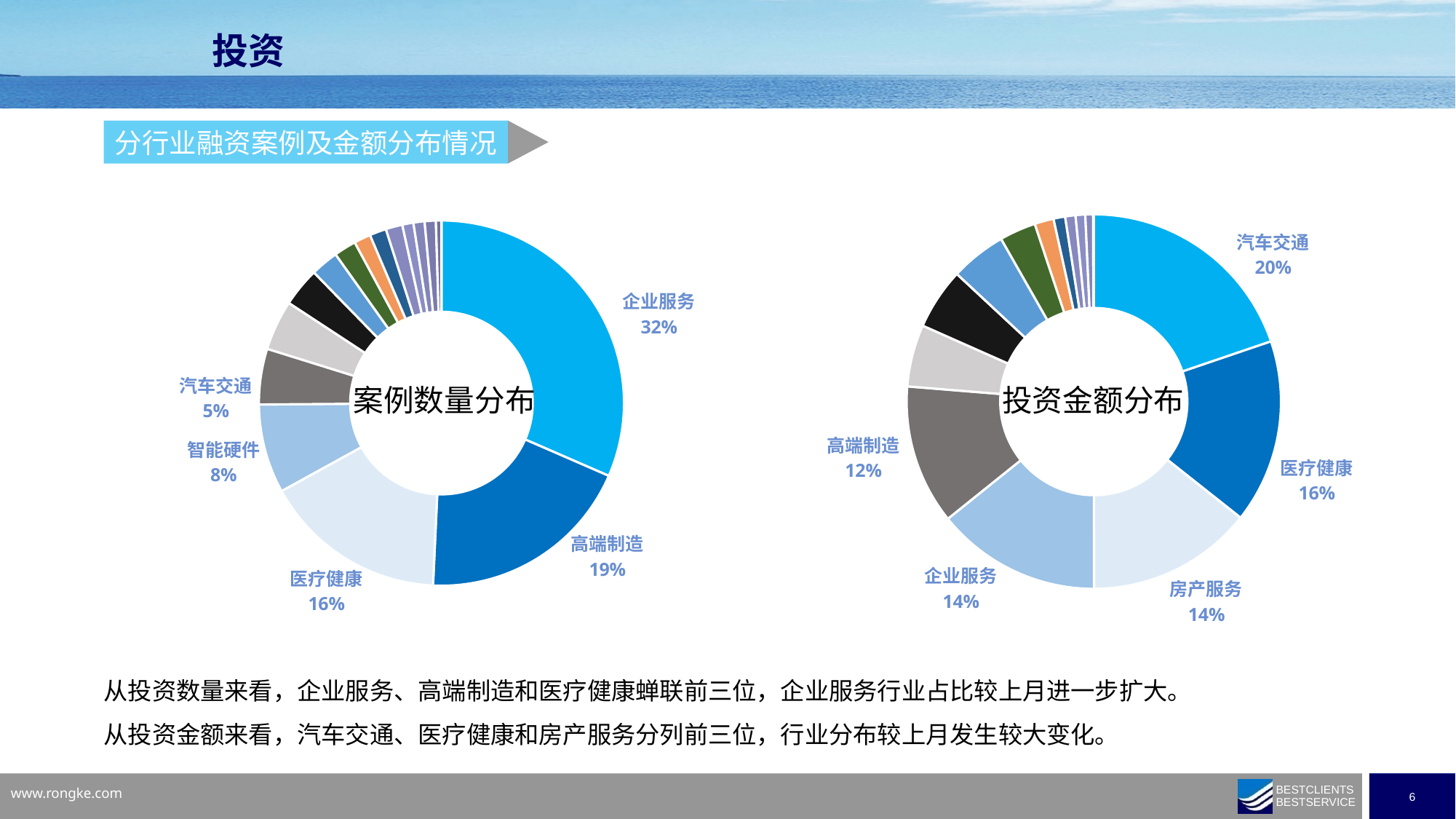
In the 投资金额分布 chart, which is larger, 医疗健康 or 房产服务? 医疗健康 In the 案例数量分布 chart, what share is labeled for 企业服务? 32% In the 案例数量分布 chart, what share is labeled for 汽车交通? 5% In the 案例数量分布 chart, how many percentage points larger is 企业服务 than 高端制造? 13 percentage points In the 案例数量分布 chart, what share is labeled for 高端制造? 19% In the 投资金额分布 chart, what share is labeled for 汽车交通? 20% In the 投资金额分布 chart, which labeled industry has the largest share? 汽车交通 Is the share of 企业服务 larger in the 案例数量分布 chart or in the 投资金额分布 chart? 案例数量分布 In the 投资金额分布 chart, what share is labeled for 医疗健康? 16% What type of chart is used for 案例数量分布 and 投资金额分布? Pie (donut) chart In the 案例数量分布 chart, which labeled industry has the largest share? 企业服务 In the 投资金额分布 chart, what share is labeled for 高端制造? 12%